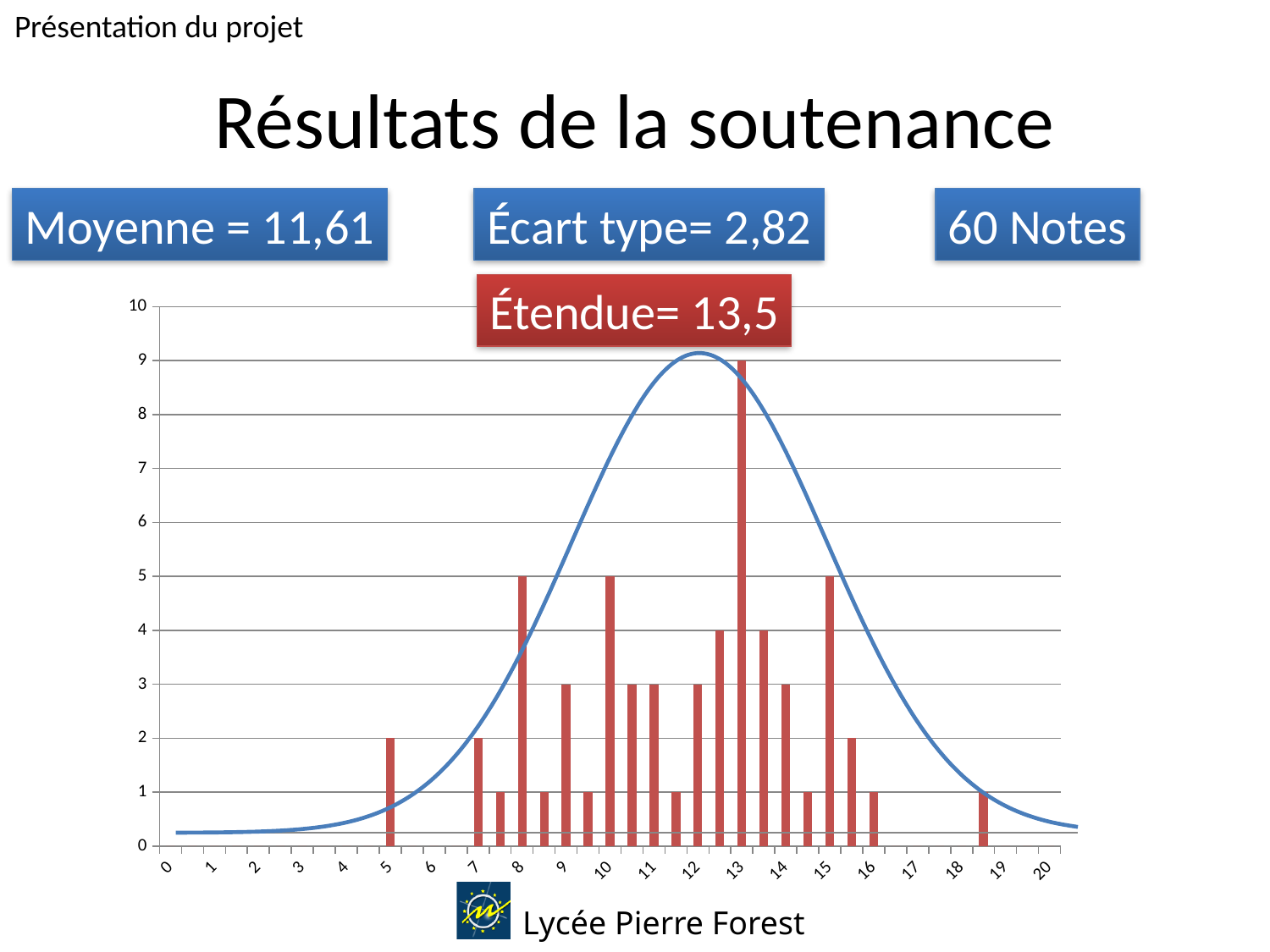
What is the value of the bar at 8 on the x axis? 5 What is the maximum value shown on the y axis? 10 What is the value of the bar at 16 on the x axis? 1 What is the difference between the bar at 13 and the bar at 15? 4 What is the value of the bar at 13 on the x axis? 9 What is the value of the bar at 5 on the x axis? 2 What kind of chart is used for the red data series? bar chart Which bar is taller, the one at 9 or the one at 15? 15 Is the value of the bar at 13 greater or less than 8? greater At which x-axis value is the tallest bar? 13 What is the title of the slide containing the chart? Résultats de la soutenance What is the value of the bar at 10 on the x axis? 5